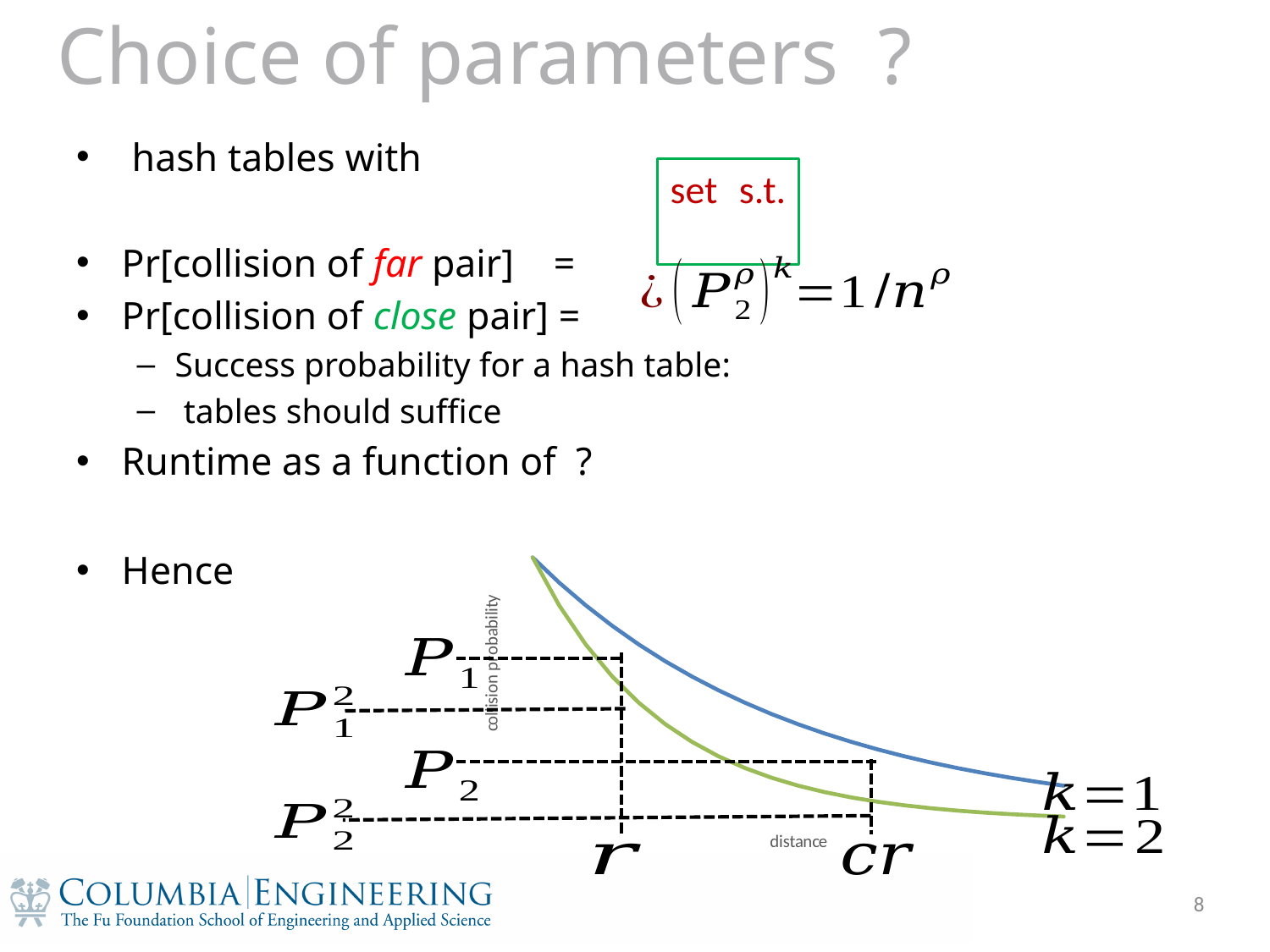
Which curve has the higher collision probability overall, k=1 or k=2? k=1 How many distances are marked with dashed vertical lines on the x axis? 2 What is the label of the y axis of the chart? collision probability Which curve lies higher at distance r, k=1 or k=2? k=1 What kind of chart is shown at the bottom of the slide? line chart Do the curves rise or fall as distance increases? fall What are the two distances marked on the x axis? r and cr Which curve lies lower at distance cr, k=1 or k=2? k=2 Which curve is labelled k=1, the blue one or the green one? the blue one How many curves are plotted in the chart? 2 What is the label of the x axis of the chart? distance